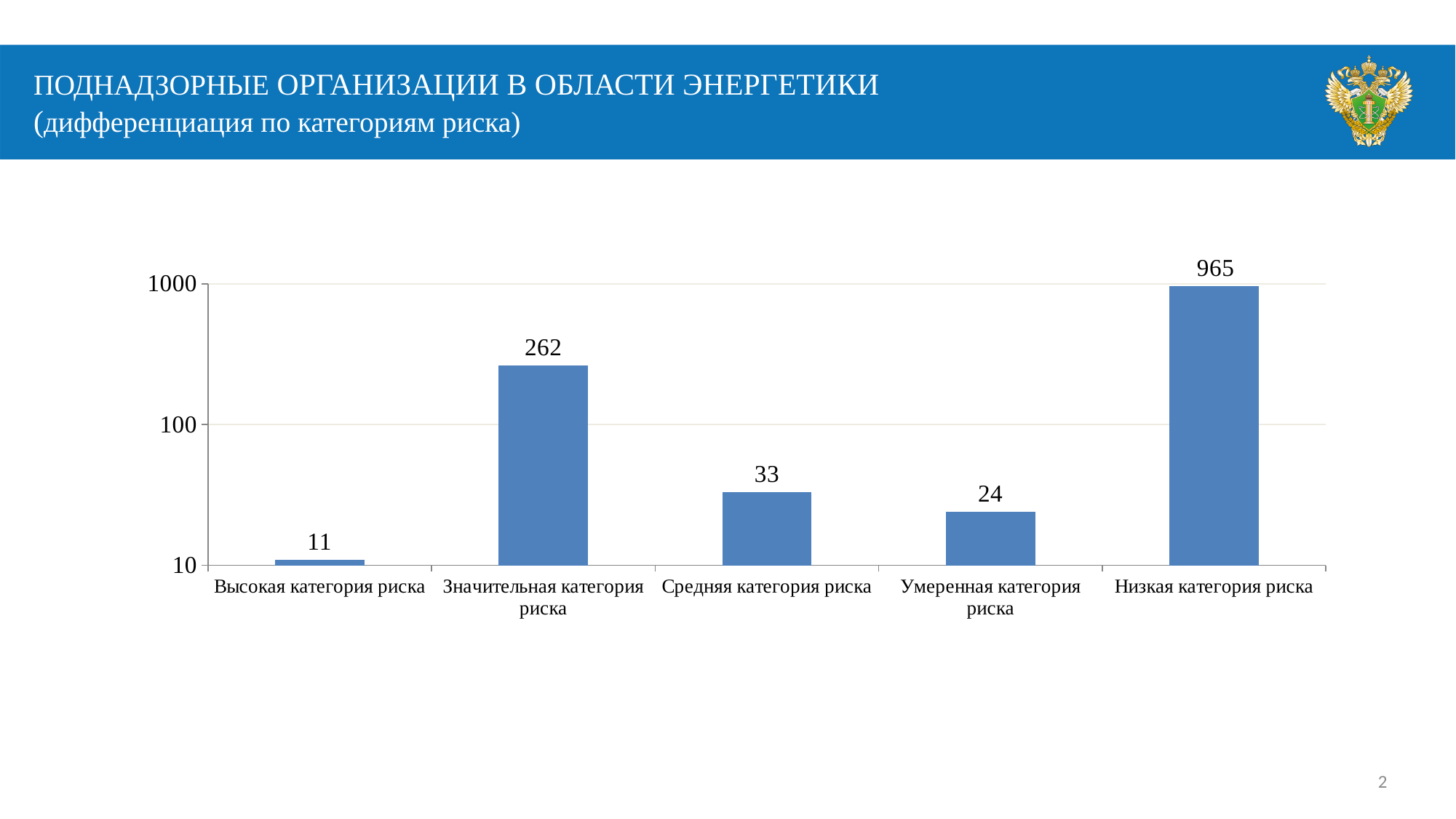
Which is larger, the value for Средняя категория риска or Умеренная категория риска? Средняя категория риска Which category has the highest value? Низкая категория риска What is the value for Средняя категория риска? 33 What is the value for Низкая категория риска? 965 What is the value for Высокая категория риска? 11 What is the value for Умеренная категория риска? 24 What is the difference between the values for Низкая категория риска and Значительная категория риска? 703 What is the value for Значительная категория риска? 262 What is the highest tick value shown on the vertical axis? 1000 What kind of chart is shown on the slide? Bar chart How many categories are shown on the chart? 5 Which category has the lowest value? Высокая категория риска